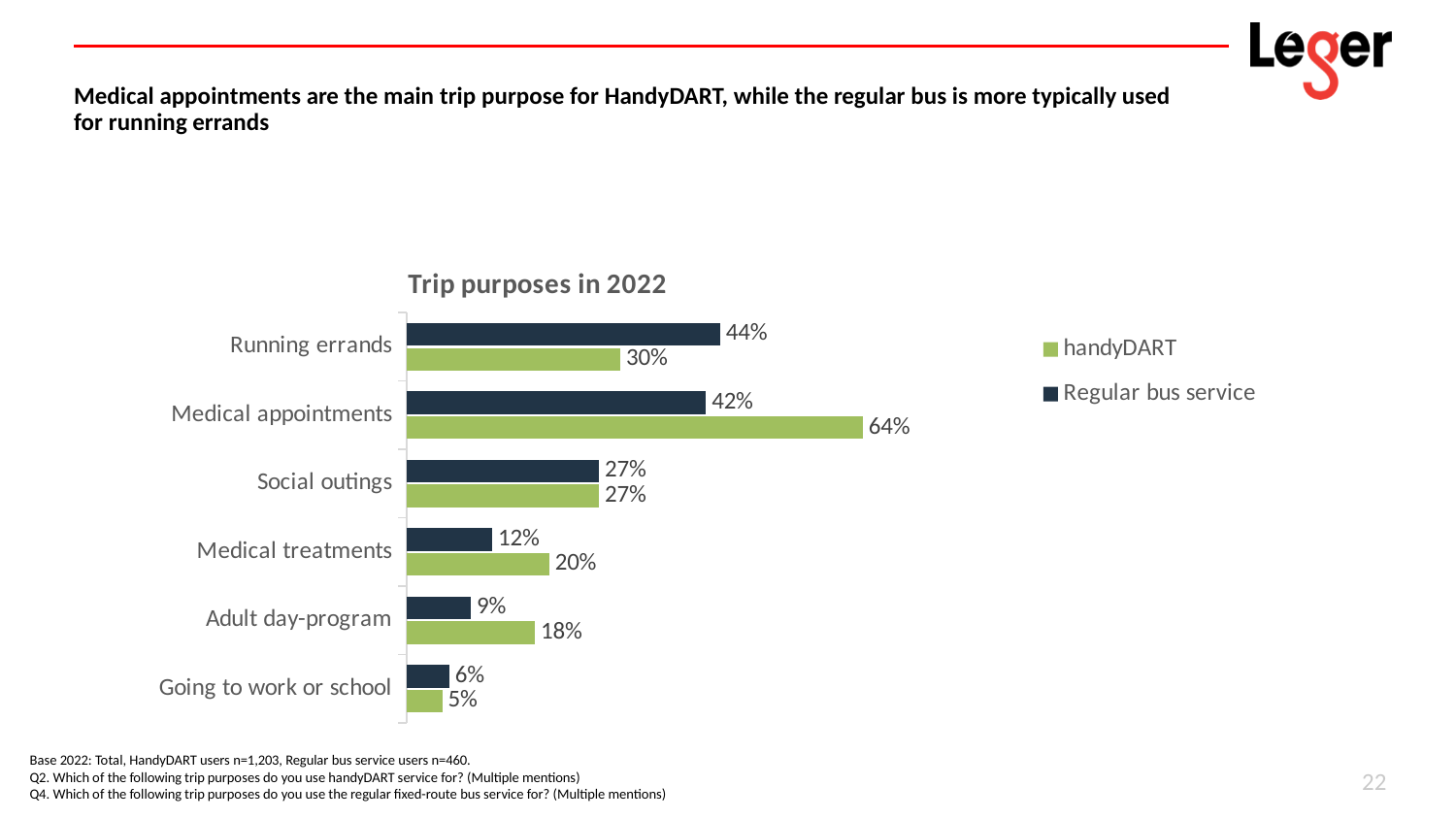
Which trip purpose has the lowest Regular bus service value? Going to work or school What is the handyDART value for Medical appointments? 64% What is the difference between the handyDART and Regular bus service values for Medical appointments? 22% What is the title of the chart? Trip purposes in 2022 What is the handyDART value for Adult day-program? 18% What kind of chart is shown on the slide? Bar chart What is the Regular bus service value for Running errands? 44% Which trip purpose has the highest handyDART value? Medical appointments How many trip purposes are shown in the chart? 6 Which is larger for Running errands: the handyDART value or the Regular bus service value? Regular bus service How many series does the legend list? 2 Which series is shown in green in the chart? handyDART